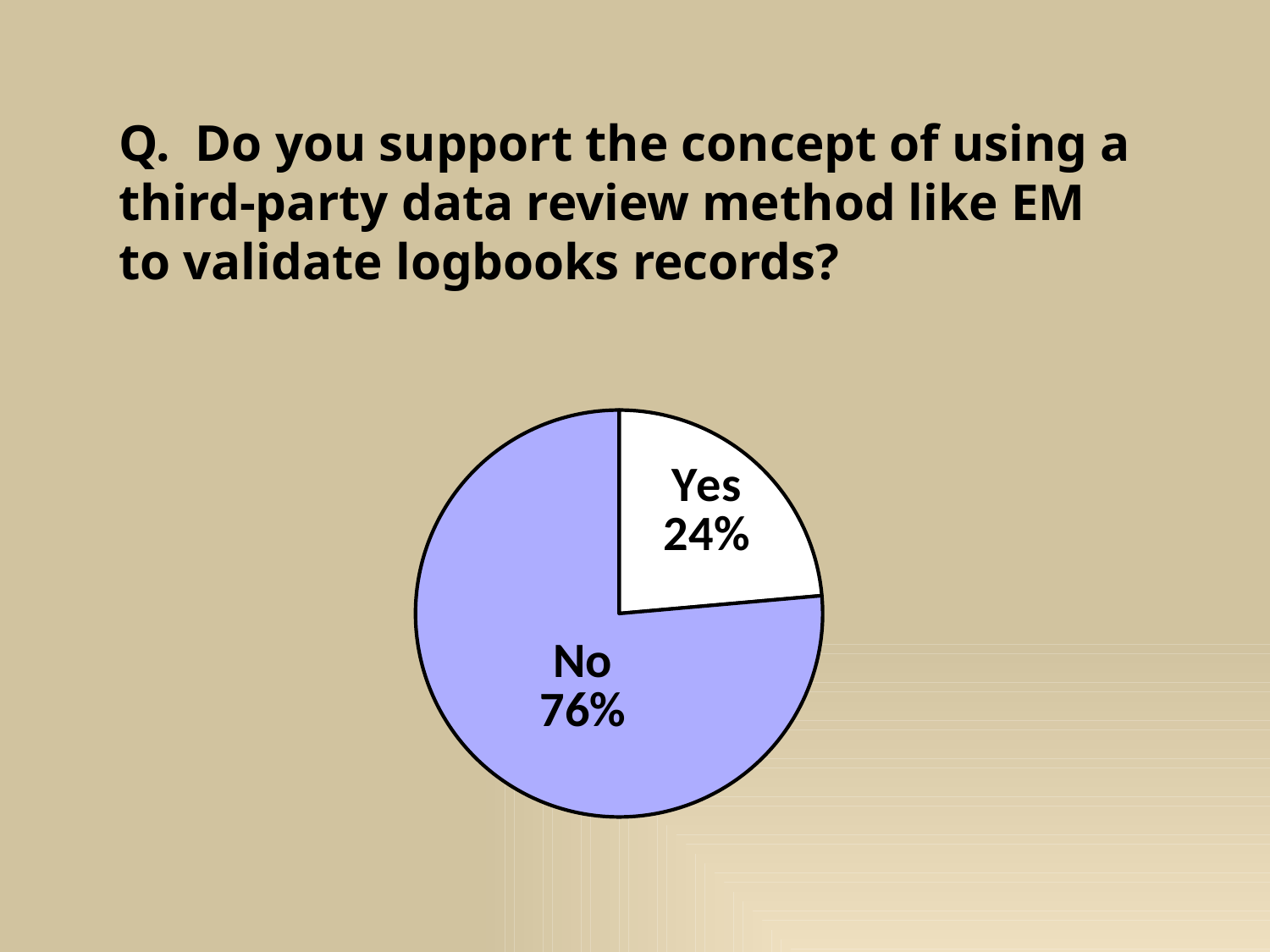
What share of the pie does the "No" slice represent? 76% Which is larger, the "Yes" slice or the "No" slice? No What is the difference in percentage points between the "No" and "Yes" slices? 52 What percentage of respondents answered "Yes"? 24% What kind of chart is shown on the slide? pie chart What colour is the "Yes" slice of the pie? white How many slices does the pie chart have? 2 What percentage of respondents answered "No"? 76% Which response has the largest share of the pie? No What colour is the "No" slice of the pie? light purple Which response has the smallest share of the pie? Yes